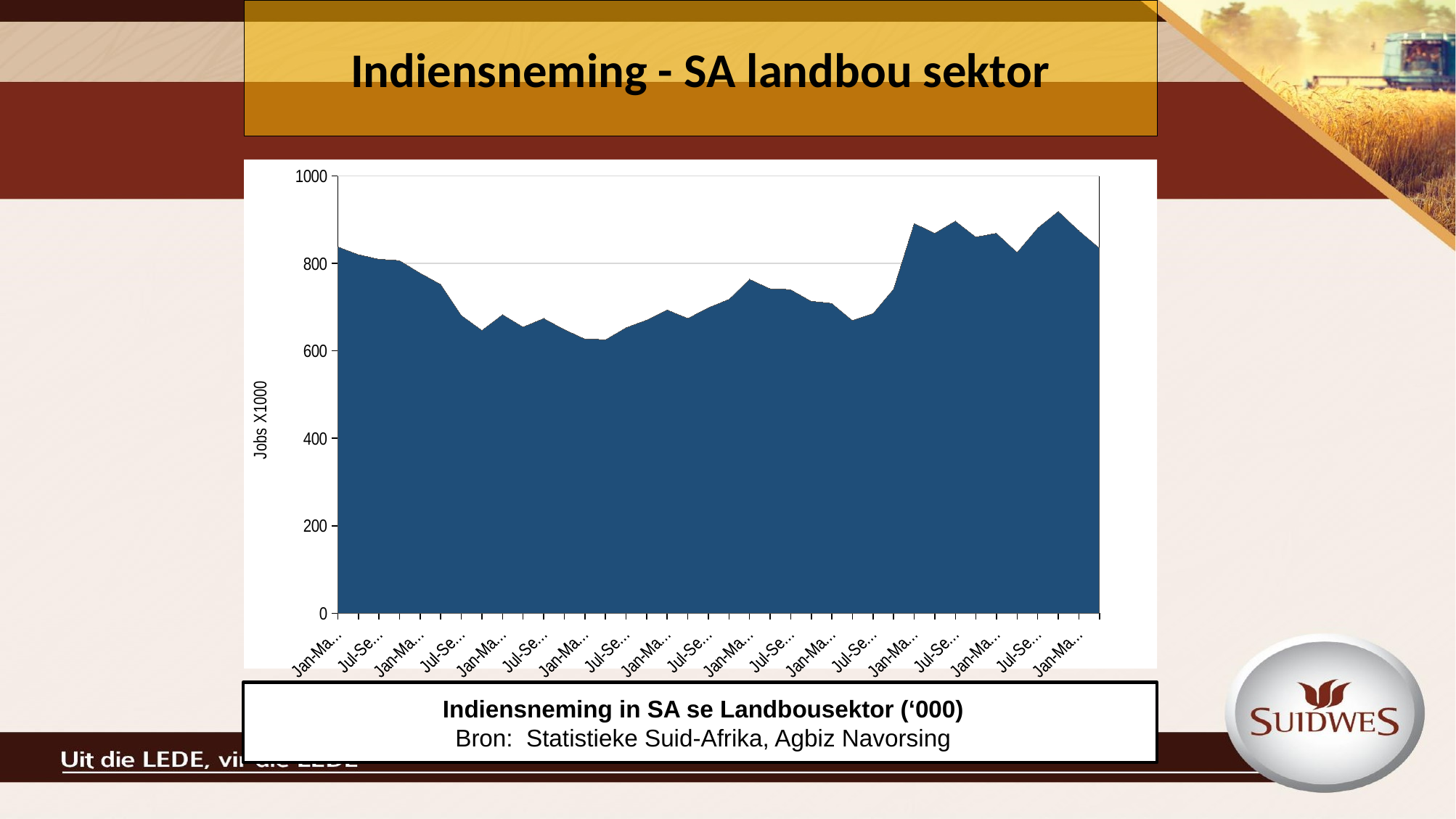
What is the label on the vertical axis of the chart? Jobs X1000 Does the series rise or fall over the first few periods from the left edge of the chart? fall Is the highest point of the series greater or less than 1000? less Is the highest point of the series greater or less than 800? greater What kind of chart is shown on the slide? area chart According to the caption below the chart, what is the source of the data? Statistieke Suid-Afrika, Agbiz Navorsing Is the lowest point of the series greater or less than 600? greater